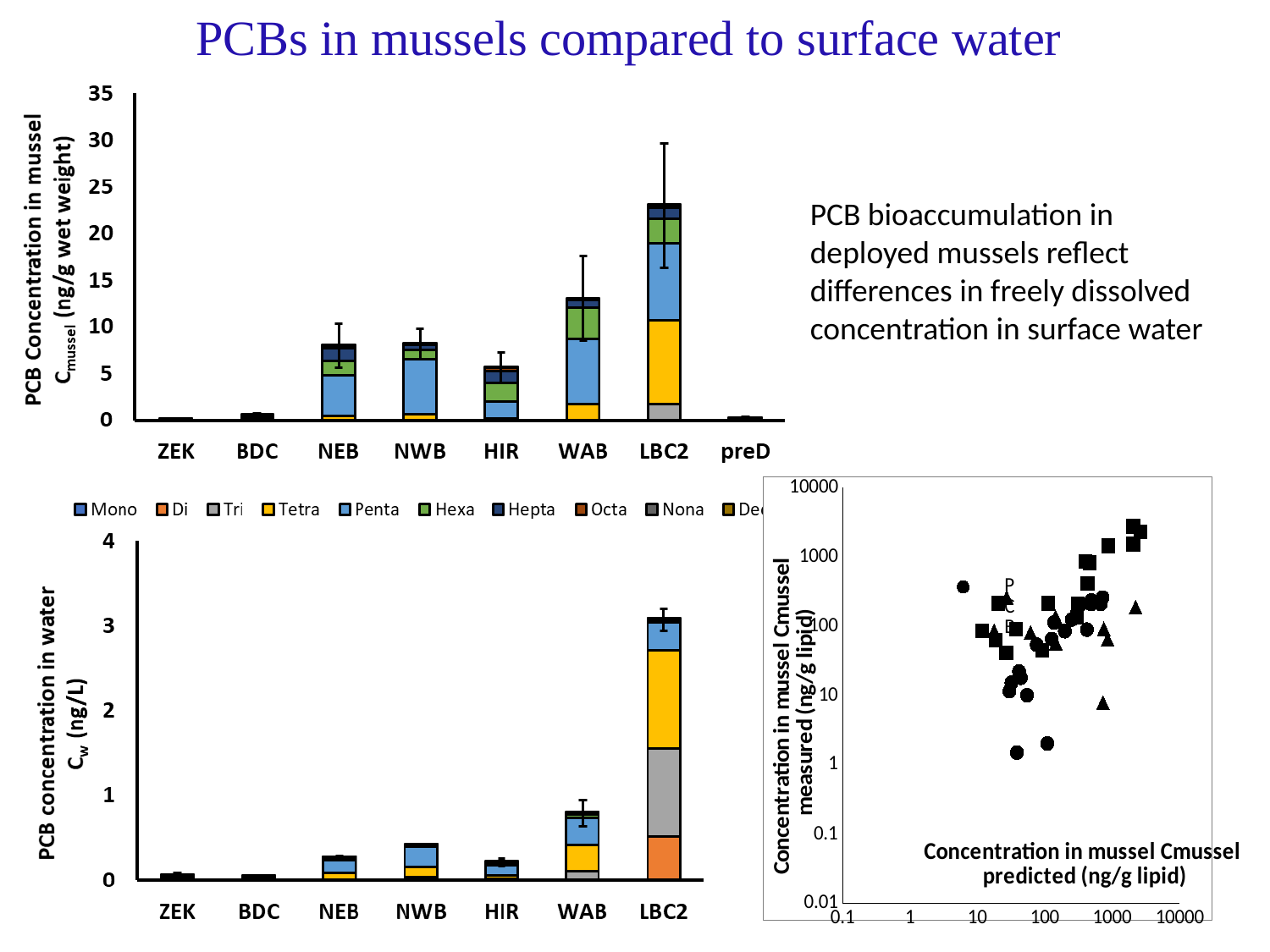
In the top-left chart (PCB Concentration in mussel), is the total value for HIR greater or less than 10? less In the top-left chart (PCB Concentration in mussel), which site has a larger total, WAB or NEB? WAB In the top-left chart (PCB Concentration in mussel), is the total value for WAB greater or less than 10? greater In the bottom-left chart (PCB concentration in water), how many sites are shown on the x axis? 7 In the bottom-left chart (PCB concentration in water), which site has the highest total PCB concentration? LBC2 In the top-left chart (PCB Concentration in mussel), is the total value for LBC2 greater or less than 20? greater What kind of chart is the top-left chart of PCB Concentration in mussel? stacked bar chart What kind of chart is the bottom-right chart comparing measured and predicted mussel concentrations? scatter plot In the top-left chart (PCB Concentration in mussel), which site has the highest total PCB concentration? LBC2 In the top-left chart (PCB Concentration in mussel), how many sites are shown on the x axis? 8